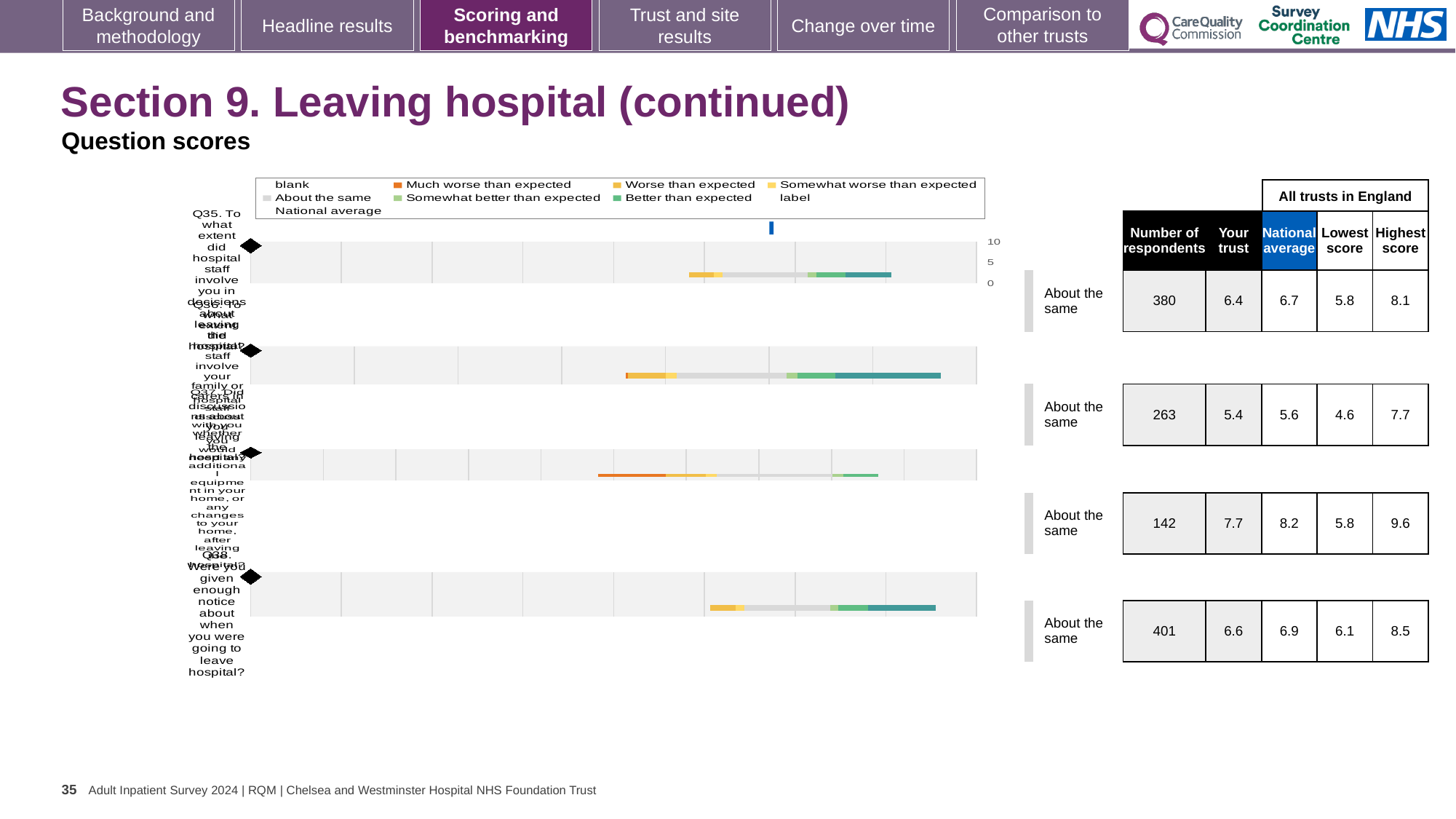
What is the national average for the third row of the table? 8.2 In the chart legend, which colour represents 'Much worse than expected'? orange Which row has the lowest number of respondents? the third row (142) What benchmark category is shown for each of the four questions? About the same What is the number of respondents for the first row (Q35)? 380 For the last row (Q38), which is larger: the 'Your trust' score or the national average? national average What kind of chart is shown on the slide? bar chart What is the difference between the national average and the 'Your trust' score for the first row (Q35)? 0.3 What is the 'Your trust' score for the first row (Q35)? 6.4 What is the 'Your trust' score for the last row (Q38)? 6.6 In the chart legend, which colour represents 'About the same'? grey How many question rows are plotted in the chart? 4